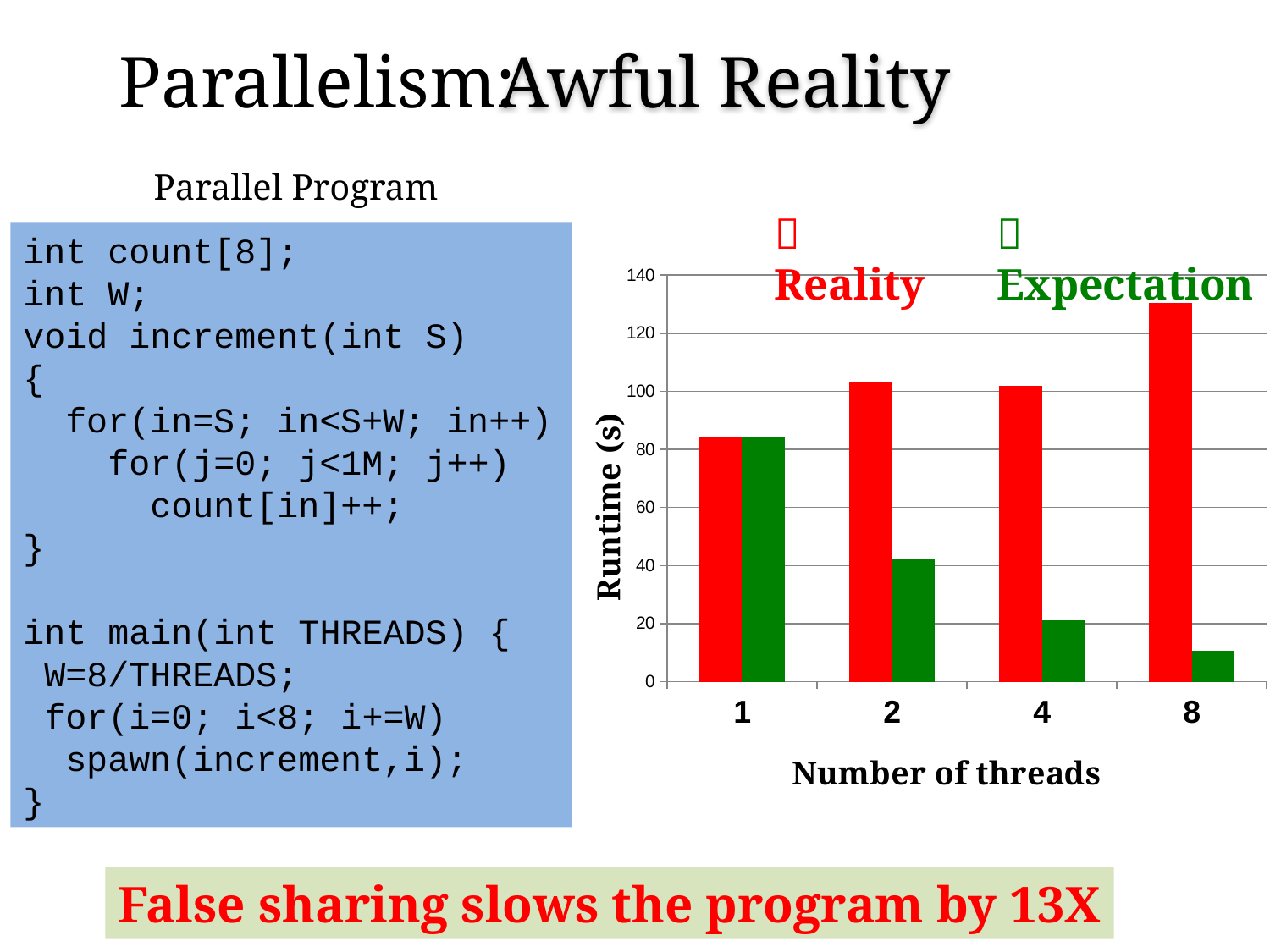
Is the Reality value for 8 threads greater or less than 120? greater Is the Expectation value for 8 threads greater or less than 20? less Does the Expectation runtime rise or fall as the number of threads increases? fall What kind of chart is shown on the slide? bar chart How many thread-count categories are shown on the x axis? 4 Is the Expectation value for 4 threads greater or less than 40? less For which number of threads is the Reality runtime highest? 8 How many series does the chart's legend list? 2 For which number of threads is the Expectation runtime lowest? 8 At 4 threads, which is larger, the Reality runtime or the Expectation runtime? Reality What is the label of the chart's y axis? Runtime (s)